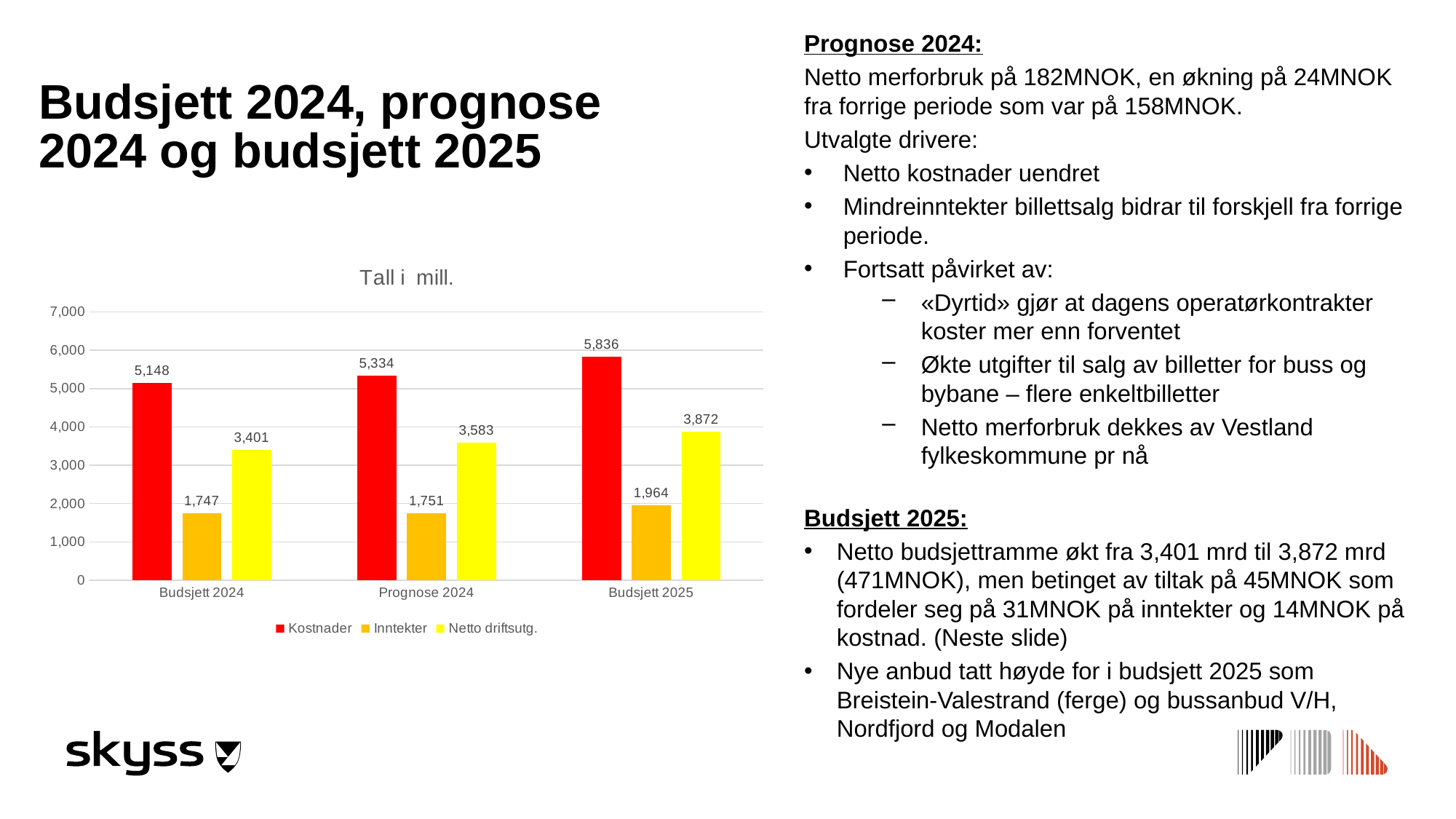
What is the value of Inntekter for Prognose 2024? 1,751 What is the value of Kostnader for Budsjett 2024? 5,148 What is the title of the chart? Tall i mill. What kind of chart is shown on the slide? bar chart What is the value of Netto driftsutg. for Budsjett 2025? 3,872 Which is larger: Netto driftsutg. for Prognose 2024 or Inntekter for Budsjett 2025? Netto driftsutg. for Prognose 2024 Is the value of Kostnader for Prognose 2024 greater or less than 5,000? greater How many categories are shown on the x axis? 3 What is the difference between Kostnader for Budsjett 2025 and Kostnader for Budsjett 2024? 688 How many series does the legend list? 3 Which category has the lowest Netto driftsutg. value? Budsjett 2024 Which category has the highest Kostnader value? Budsjett 2025